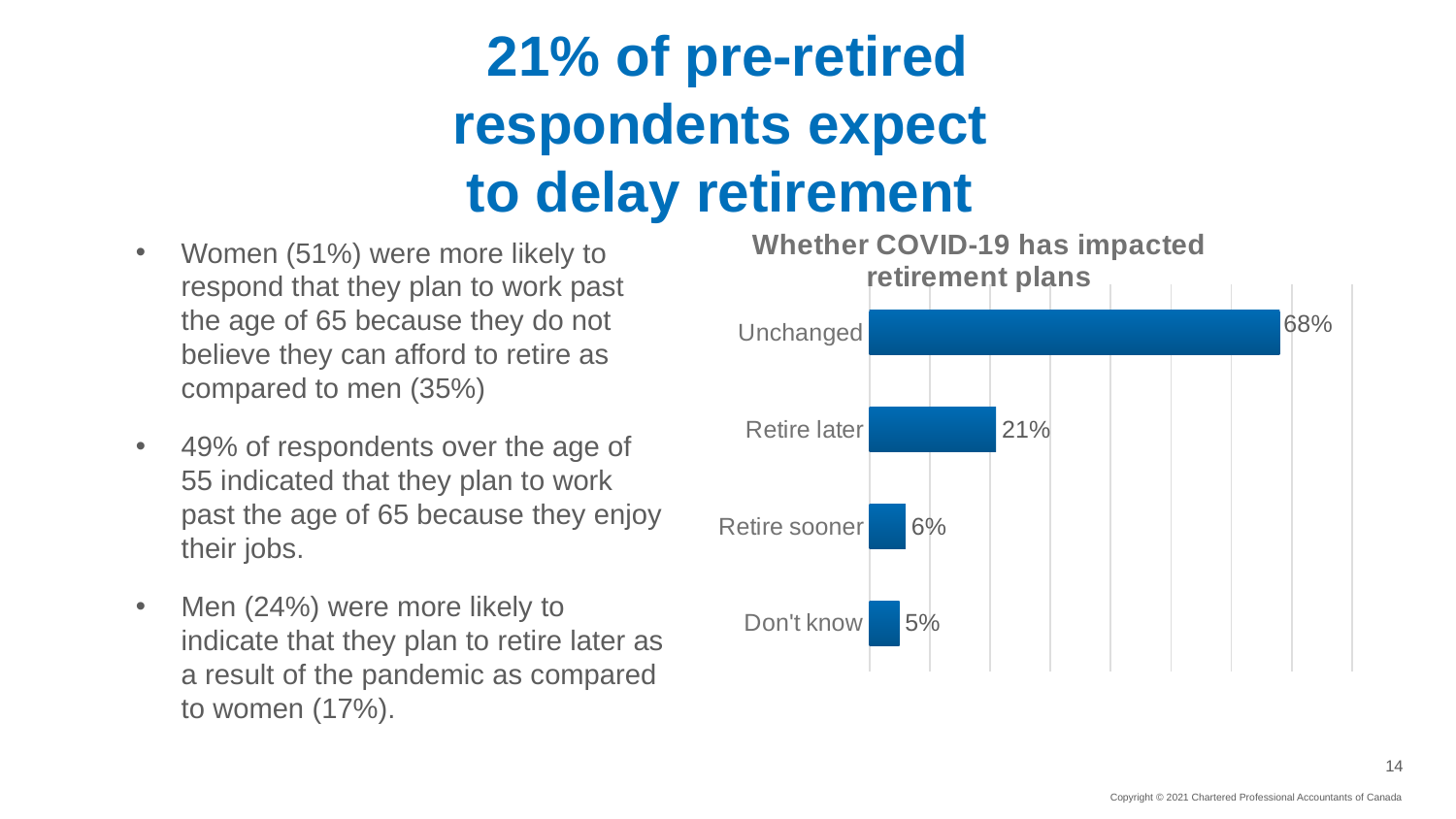
Which is larger, the value for 'Retire later' or the value for 'Retire sooner'? Retire later What is the difference between the 'Unchanged' and 'Retire later' values? 47% What percentage of respondents expect to retire later? 21% What is the difference between the 'Retire later' and 'Retire sooner' values? 15% What percentage of respondents expect to retire sooner? 6% Which category has the highest value in the chart? Unchanged What is the title of the chart? Whether COVID-19 has impacted retirement plans What percentage of respondents said their retirement plans were unchanged? 68% What type of chart is shown on the slide? Bar chart How many categories are shown in the chart? 4 What percentage of respondents answered 'Don't know'? 5% Which category has the lowest value in the chart? Don't know